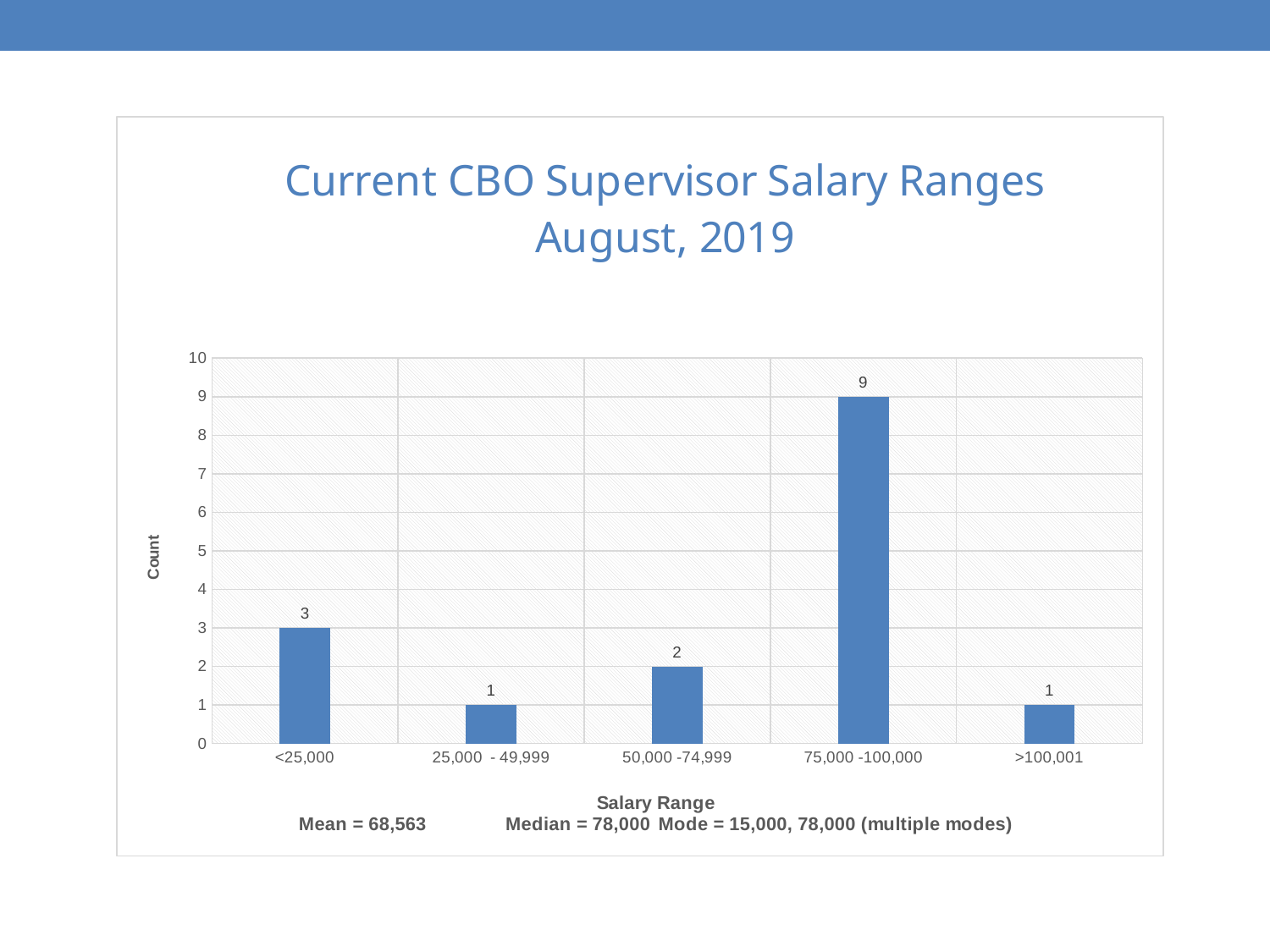
What kind of chart is shown on the slide? bar chart Which salary range has the highest count? 75,000 -100,000 What is the count for the 50,000 -74,999 salary range? 2 What is the title of the chart? Current CBO Supervisor Salary Ranges August, 2019 What is the count for the <25,000 salary range? 3 What is the count for the 75,000 -100,000 salary range? 9 What is the difference in count between the 75,000 -100,000 range and the <25,000 range? 6 What mean value is stated below the chart? 68,563 Is the count for the 75,000 -100,000 range greater or less than 5? greater How many salary range categories are shown on the x axis? 5 What is the total count across all five salary ranges? 16 Which has a larger count, the <25,000 range or the 50,000 -74,999 range? <25,000